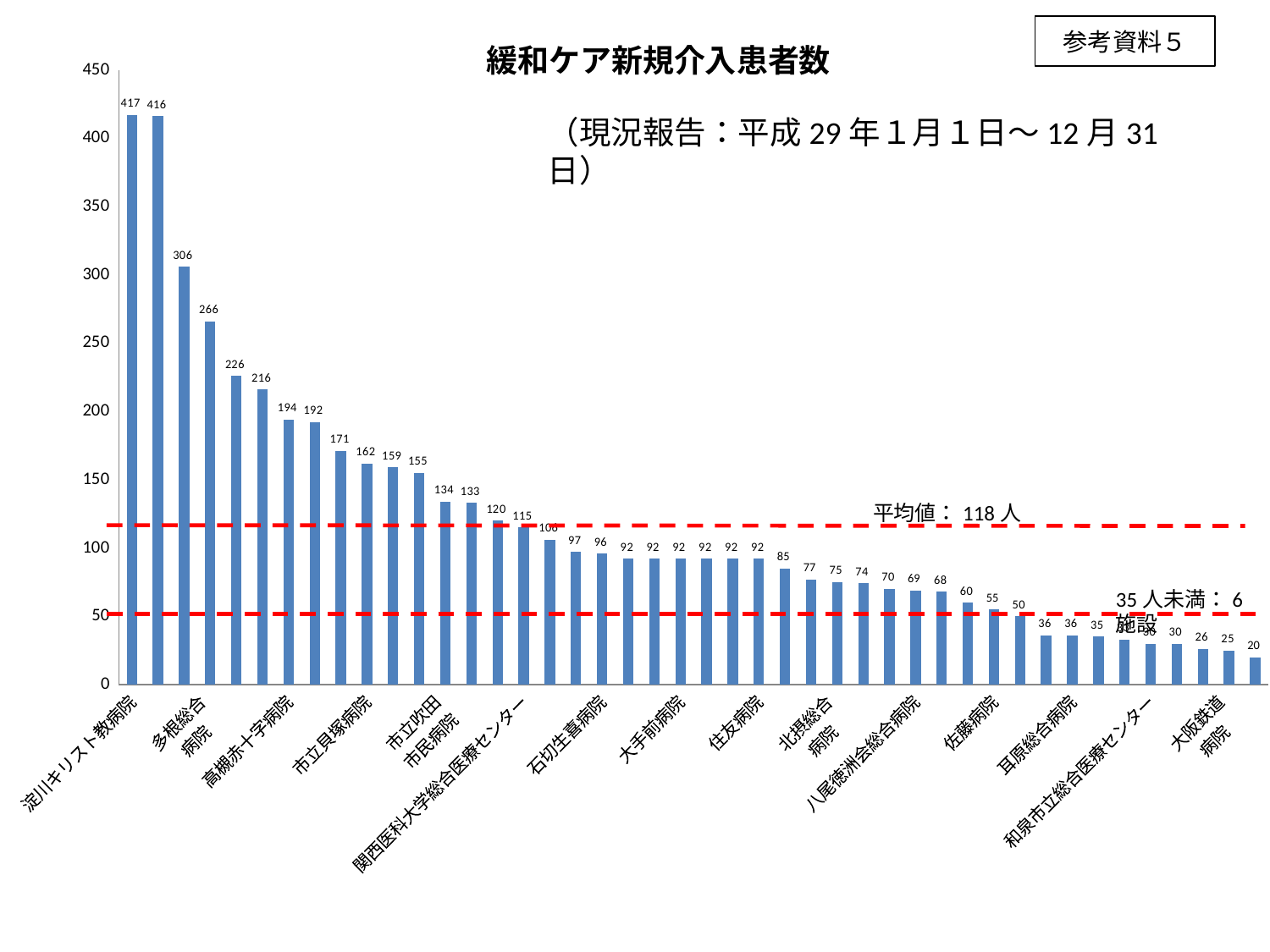
Which is larger, the value for 高槻赤十字病院 or the value for 住友病院? 高槻赤十字病院 Do the values rise or fall from left to right along the x axis? fall Is the value for 佐藤病院 greater or less than 100? less What is the value for 市立吹田市民病院? 134 What is the value for 大阪鉄道病院? 25 Is the value for 多根総合病院 greater or less than 250? greater What average value (平均値) is indicated by the dashed line on the chart? 118人 What is the difference between the values for 淀川キリスト教病院 and 大阪鉄道病院? 392 Which hospital has the highest number of new palliative care patients? 淀川キリスト教病院 What is the value for 淀川キリスト教病院? 417 What kind of chart is shown on the slide? bar chart